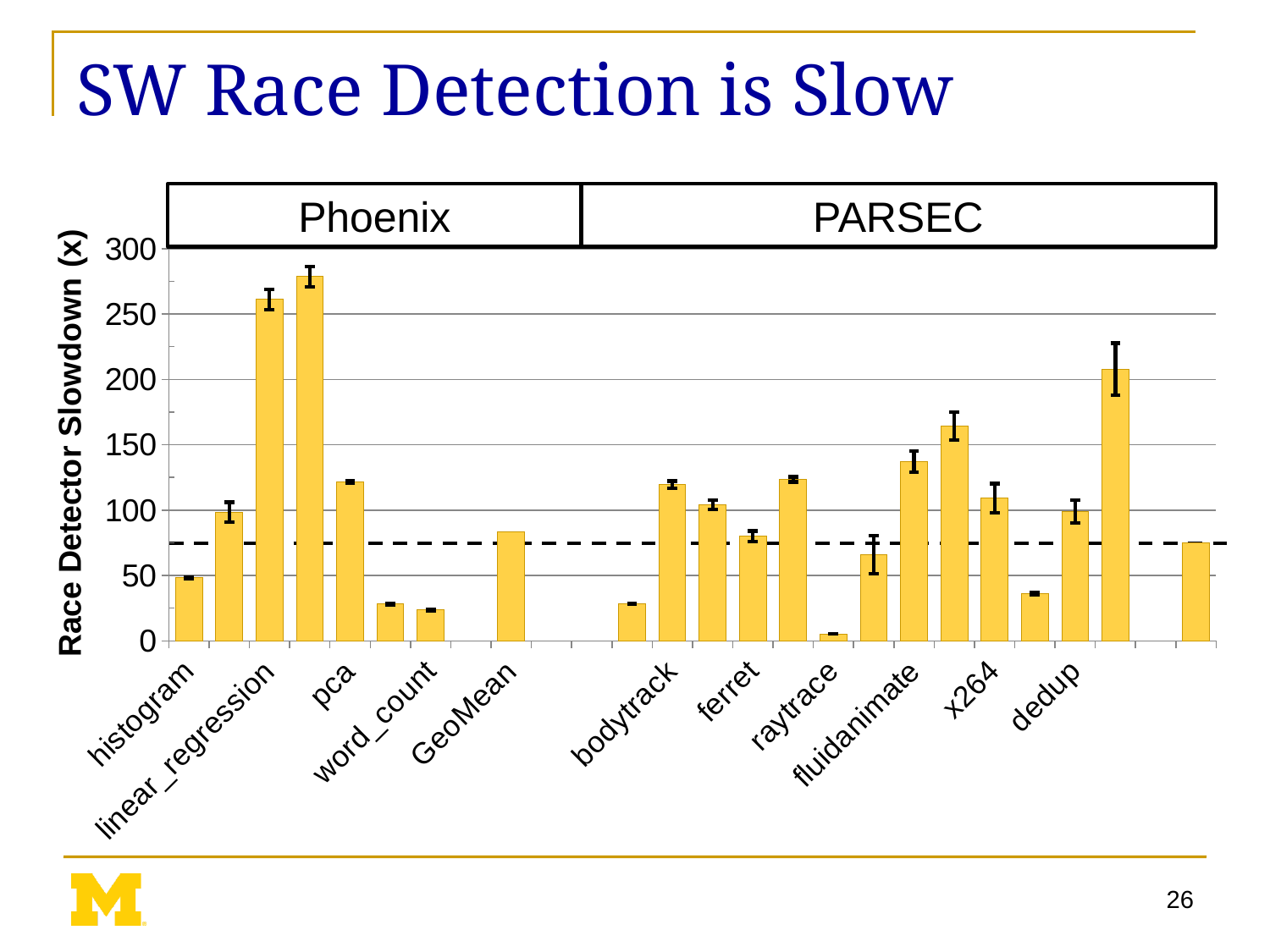
Which has a smaller slowdown, raytrace or fluidanimate? raytrace Which has a larger slowdown, linear_regression or pca? linear_regression What are the two benchmark suite groups labeled above the chart? Phoenix and PARSEC Is the value for word_count greater or less than 50? less Is the value for fluidanimate greater or less than 100? greater Is the value for linear_regression greater or less than 250? greater What is the y-axis title of the chart? Race Detector Slowdown (x) What kind of chart is shown on the slide? bar chart